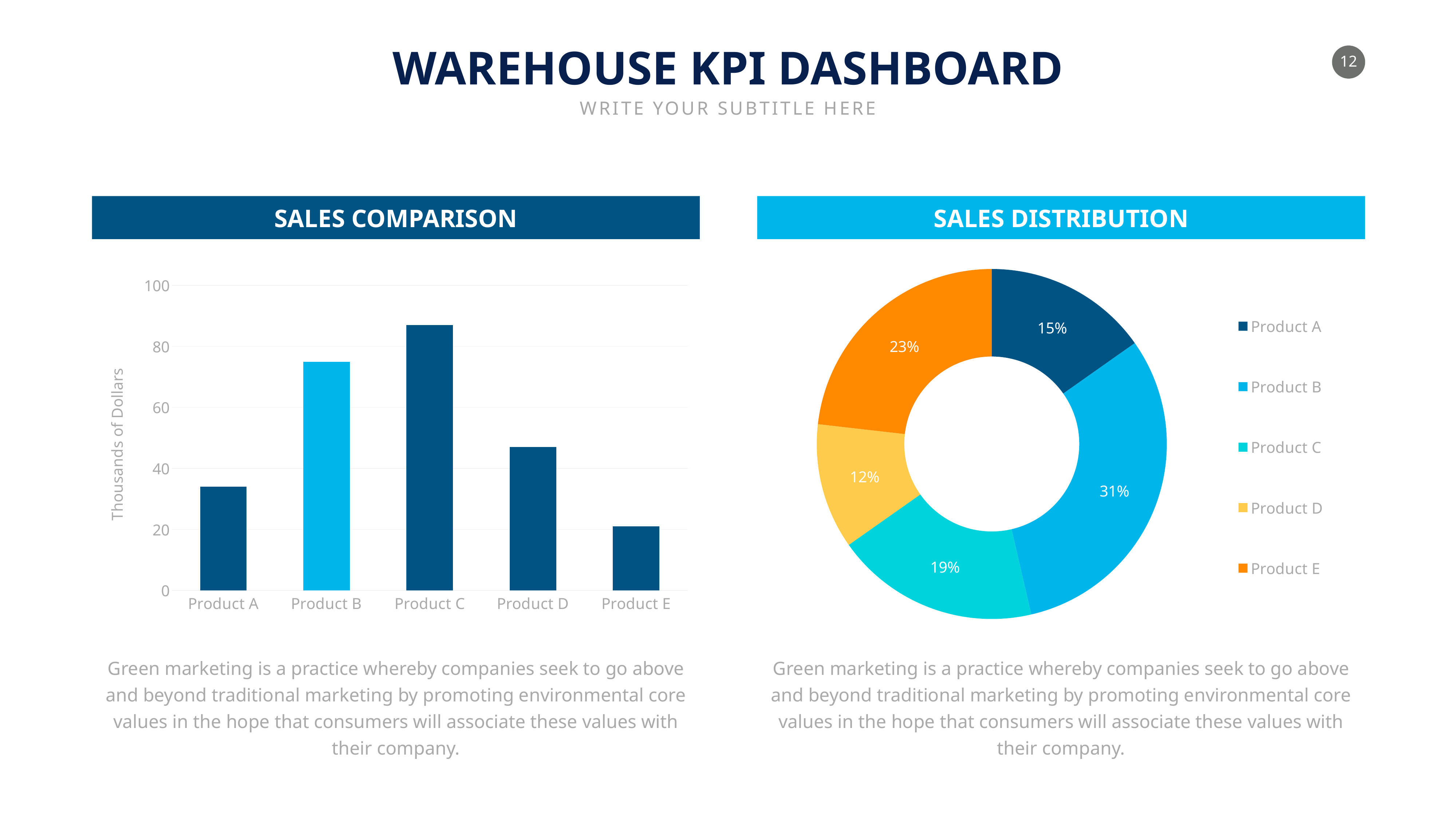
What is the label on the vertical axis of the Sales Comparison chart? Thousands of Dollars In the Sales Comparison chart, which product has the lowest bar? Product E In the Sales Distribution chart, what is the difference between the shares of Product E and Product A? 8% In the Sales Distribution chart, what share does Product B have? 31% In the Sales Comparison chart, which is larger, the value for Product D or the value for Product E? Product D In the Sales Comparison chart, which product has the highest bar? Product C How many products does the legend of the Sales Distribution chart list? 5 How many products are shown in the Sales Comparison chart? 5 In the Sales Comparison chart, is the value for Product B greater or less than 60? greater What kind of chart is the Sales Comparison chart? bar chart In the Sales Comparison chart, is the value for Product A greater or less than 40? less In the Sales Distribution chart, which product has the smallest share? Product D